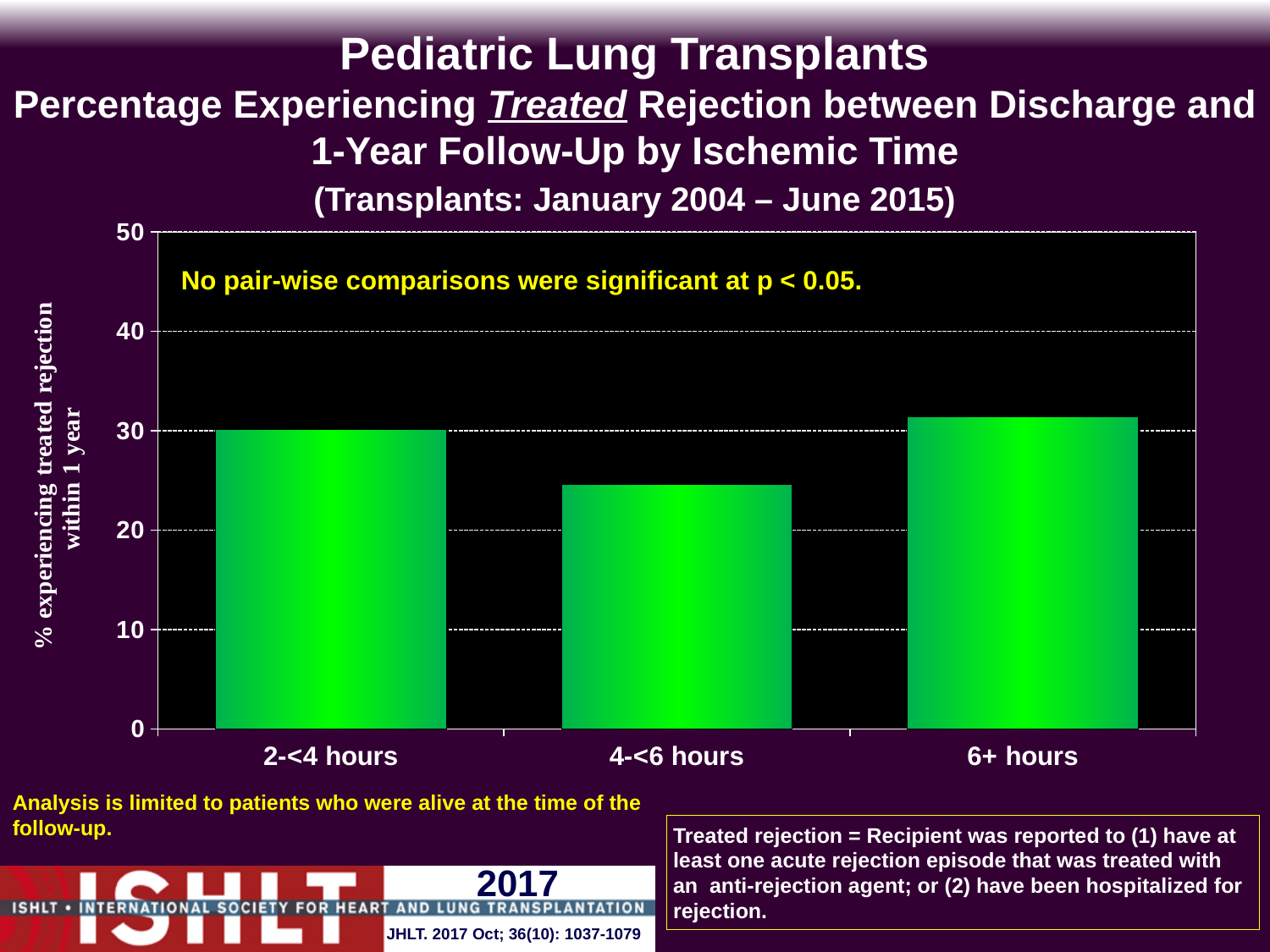
Is the value for 6+ hours greater or less than 30? greater How many ischemic time categories are shown on the x axis? 3 What is the label on the y axis of the chart? % experiencing treated rejection within 1 year What does the yellow annotation inside the chart say about pair-wise comparisons? No pair-wise comparisons were significant at p < 0.05. Which ischemic time category has the lowest percentage experiencing treated rejection? 4-<6 hours Is the value for 2-<4 hours greater or less than 20? greater Is the value for 4-<6 hours greater or less than 20? greater Which ischemic time category has the highest percentage experiencing treated rejection? 6+ hours Which is larger, the value for 4-<6 hours or the value for 6+ hours? 6+ hours What kind of chart is shown on the slide? bar chart